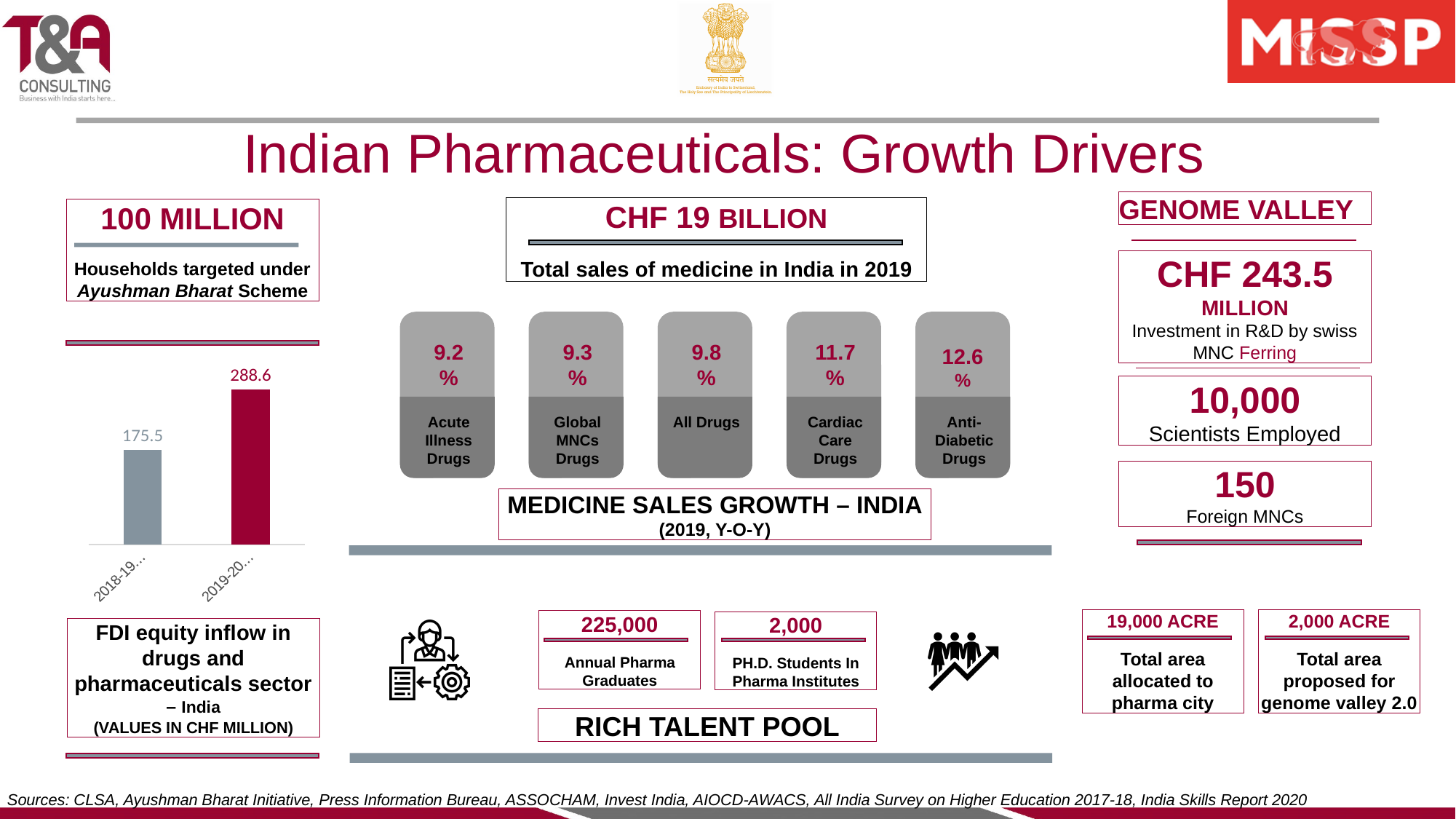
In the FDI equity inflow bar chart, which year has the highest value? 2019-20 In the FDI equity inflow bar chart, what is the value for 2018-19? 175.5 In the FDI equity inflow bar chart, what is the difference between the 2019-20 and 2018-19 values? 113.1 What type of chart is used to show FDI equity inflow in drugs and pharmaceuticals? Bar chart In what unit are the values in the FDI equity inflow bar chart expressed? CHF million In the FDI equity inflow bar chart, which is larger: the value for 2018-19 or for 2019-20? 2019-20 How many bars are plotted in the FDI equity inflow chart? 2 In the FDI equity inflow bar chart, what is the value for 2019-20? 288.6 In the FDI equity inflow bar chart, what colour is the bar for 2019-20? Dark red In the FDI equity inflow bar chart, do the values rise or fall from 2018-19 to 2019-20? Rise In the FDI equity inflow bar chart, which year has the lowest value? 2018-19